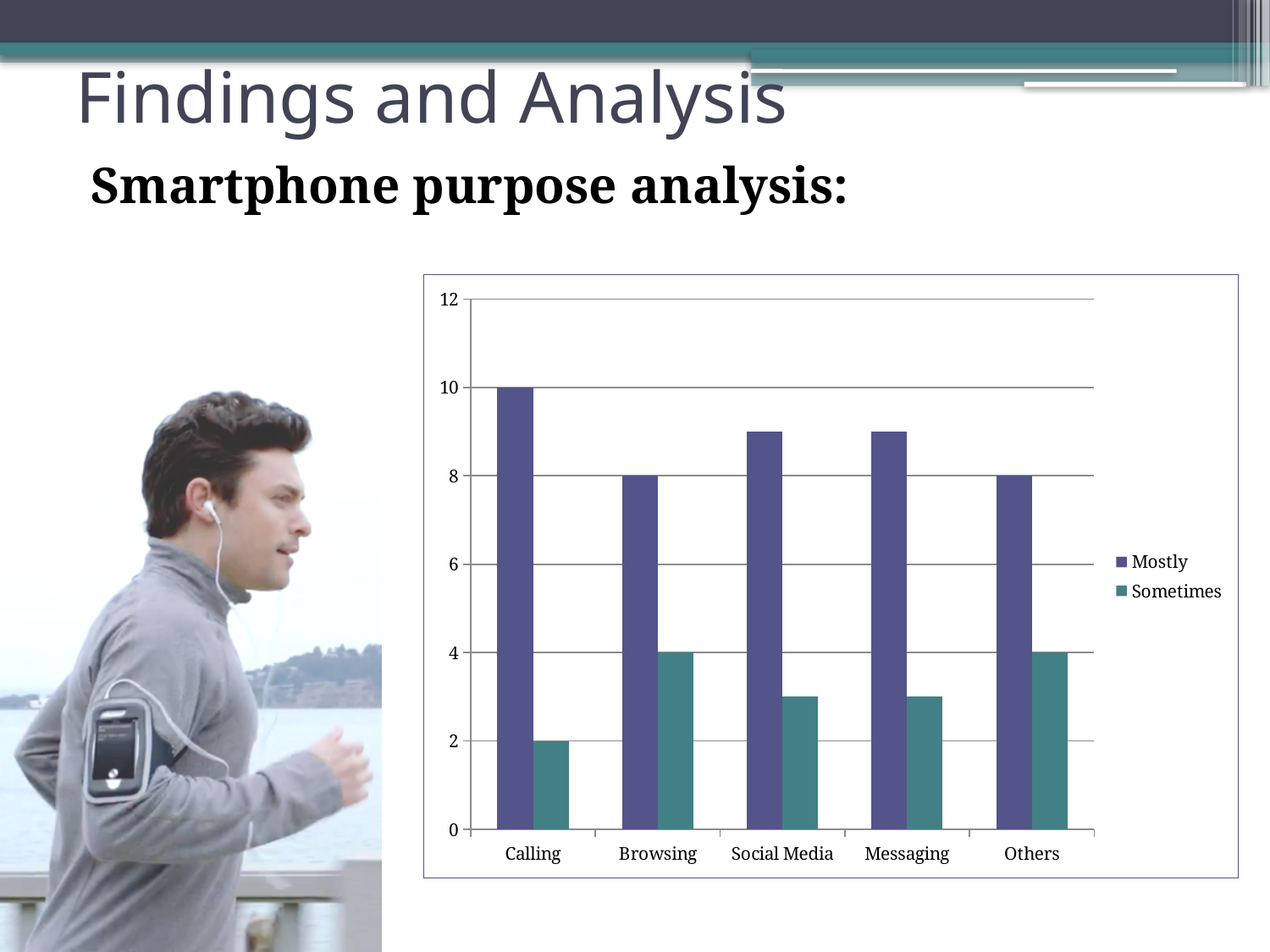
What is the value for Calling in the Mostly series? 10 Which category has the lowest value in the Sometimes series? Calling Is the Mostly value for Social Media greater or less than 8? greater Is the Sometimes value for Messaging greater or less than 4? less What is the value for Others in the Sometimes series? 4 What is the value for Browsing in the Mostly series? 8 What is the value for Calling in the Sometimes series? 2 What is the difference between the Mostly and Sometimes values for Calling? 8 What kind of chart is shown on the slide? Bar chart How many series does the legend list? 2 How many categories are shown on the x axis? 5 Which category has the highest value in the Mostly series? Calling